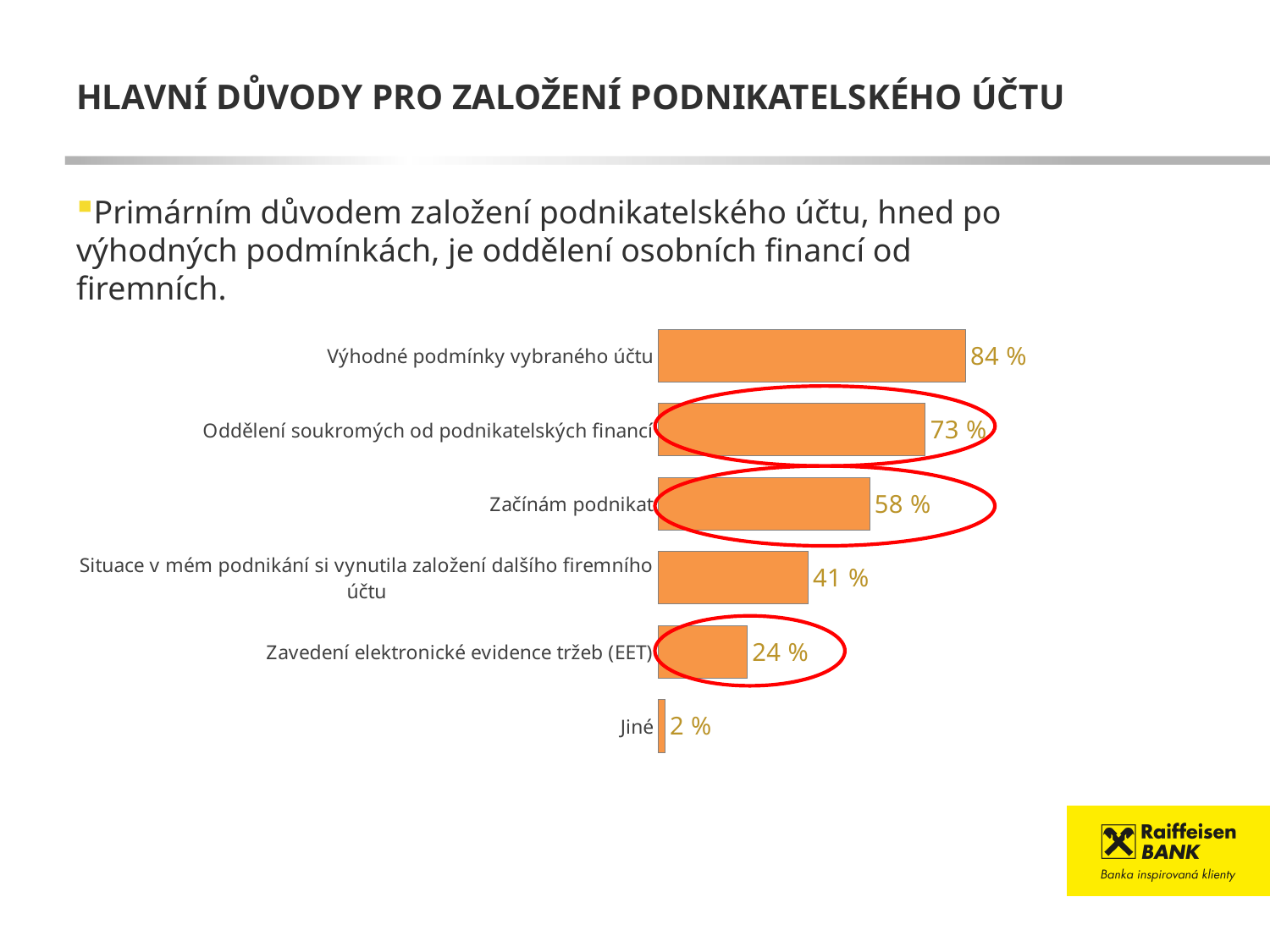
Which category has the highest value? Výhodné podmínky vybraného účtu Which is larger: the value for "Situace v mém podnikání si vynutila založení dalšího firemního účtu" or the value for "Začínám podnikat"? Začínám podnikat What is the difference between the values for "Výhodné podmínky vybraného účtu" and "Oddělení soukromých od podnikatelských financí"? 11 % What is the value for "Výhodné podmínky vybraného účtu"? 84 % What is the value for "Oddělení soukromých od podnikatelských financí"? 73 % How many categories are shown in the chart? 6 What is the difference between the values for "Začínám podnikat" and "Zavedení elektronické evidence tržeb (EET)"? 34 % What is the value for "Začínám podnikat"? 58 % What kind of chart is shown on the slide? Bar chart What is the value for "Zavedení elektronické evidence tržeb (EET)"? 24 % Which category has the lowest value? Jiné How many bars are circled in red on the chart? 3